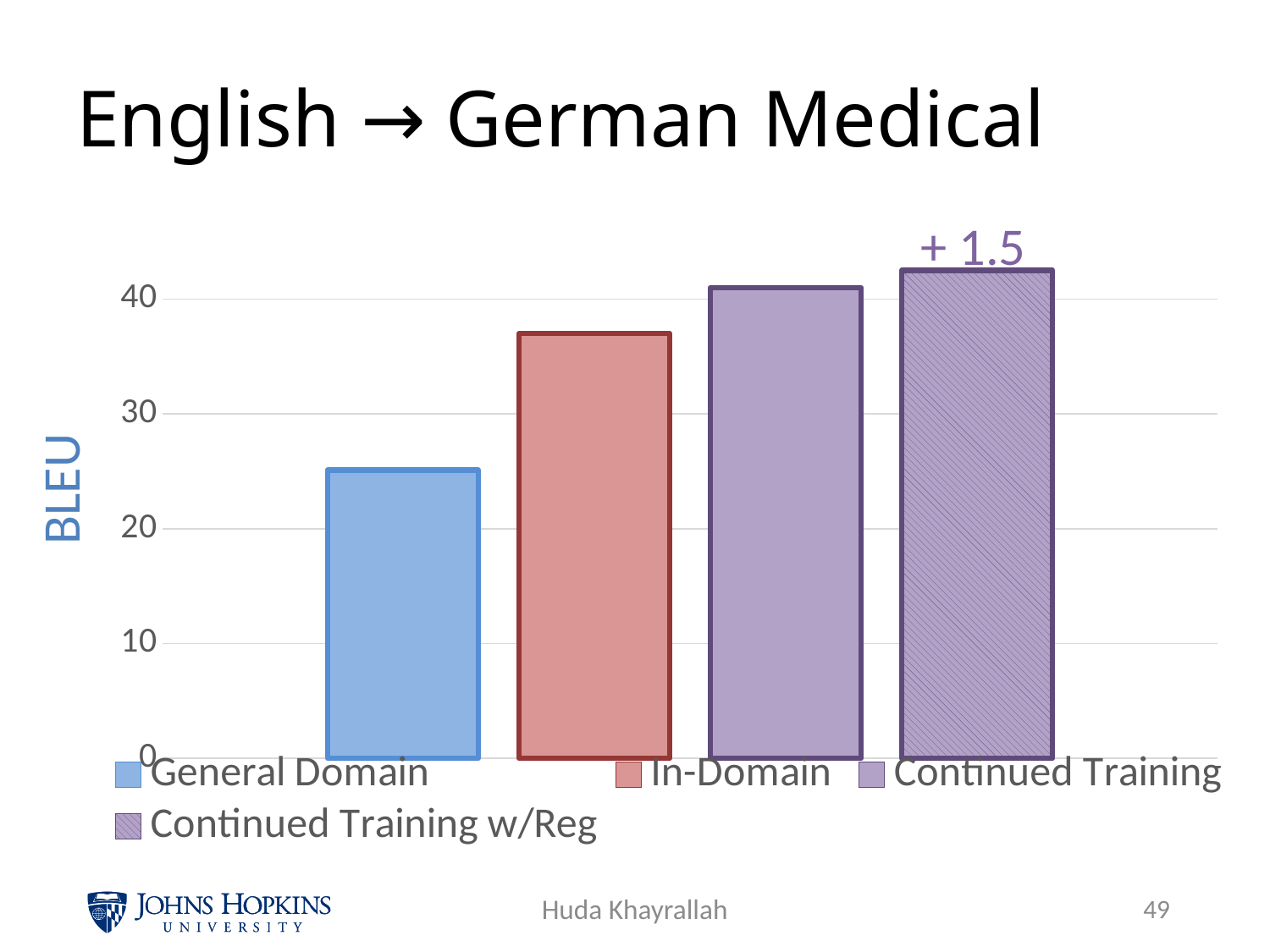
How many bars are plotted in the chart? 4 Is the value for In-Domain greater or less than 30? greater Is the value for General Domain greater or less than 30? less What kind of chart is shown on the slide? bar chart Which series has the lowest BLEU score? General Domain Is the value for In-Domain greater or less than 40? less Which is larger, the value for In-Domain or the value for General Domain? In-Domain What is the label on the vertical axis of the chart? BLEU What annotation is printed above the Continued Training w/Reg bar? + 1.5 Which is larger, the value for Continued Training or the value for In-Domain? Continued Training How many series does the legend list? 4